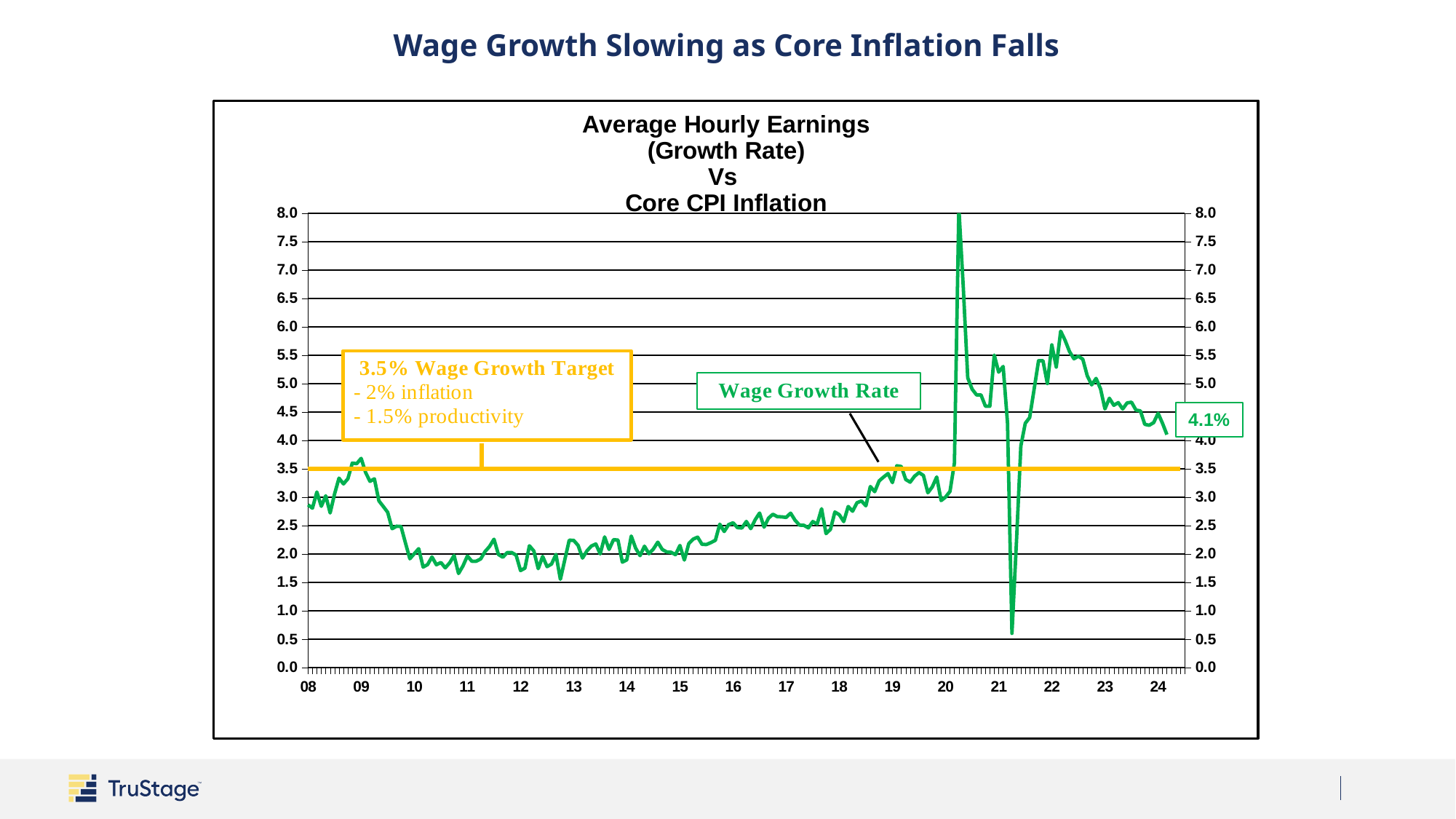
Is the lowest point of the Wage Growth Rate in 2021 greater or less than 1.0? less Is the peak of the Wage Growth Rate in 2020 greater or less than 7.5? greater By how much does the latest Wage Growth Rate (4.1%) exceed the 3.5% Wage Growth Target? 0.6% What is the most recent value of the Wage Growth Rate labelled on the chart? 4.1% Does the Wage Growth Rate rise or fall from 2022 to 2024? fall What kind of chart is shown on the slide? line chart What two components make up the 3.5% Wage Growth Target according to the annotation? 2% inflation and 1.5% productivity Is the Wage Growth Rate during 2012 greater or less than 2.5? less How many year labels are shown on the x axis? 17 What is the highest value shown on the vertical axis? 8.0 What is the Wage Growth Target shown by the horizontal yellow line? 3.5% Is the latest Wage Growth Rate of 4.1% greater or less than the 3.5% Wage Growth Target? greater